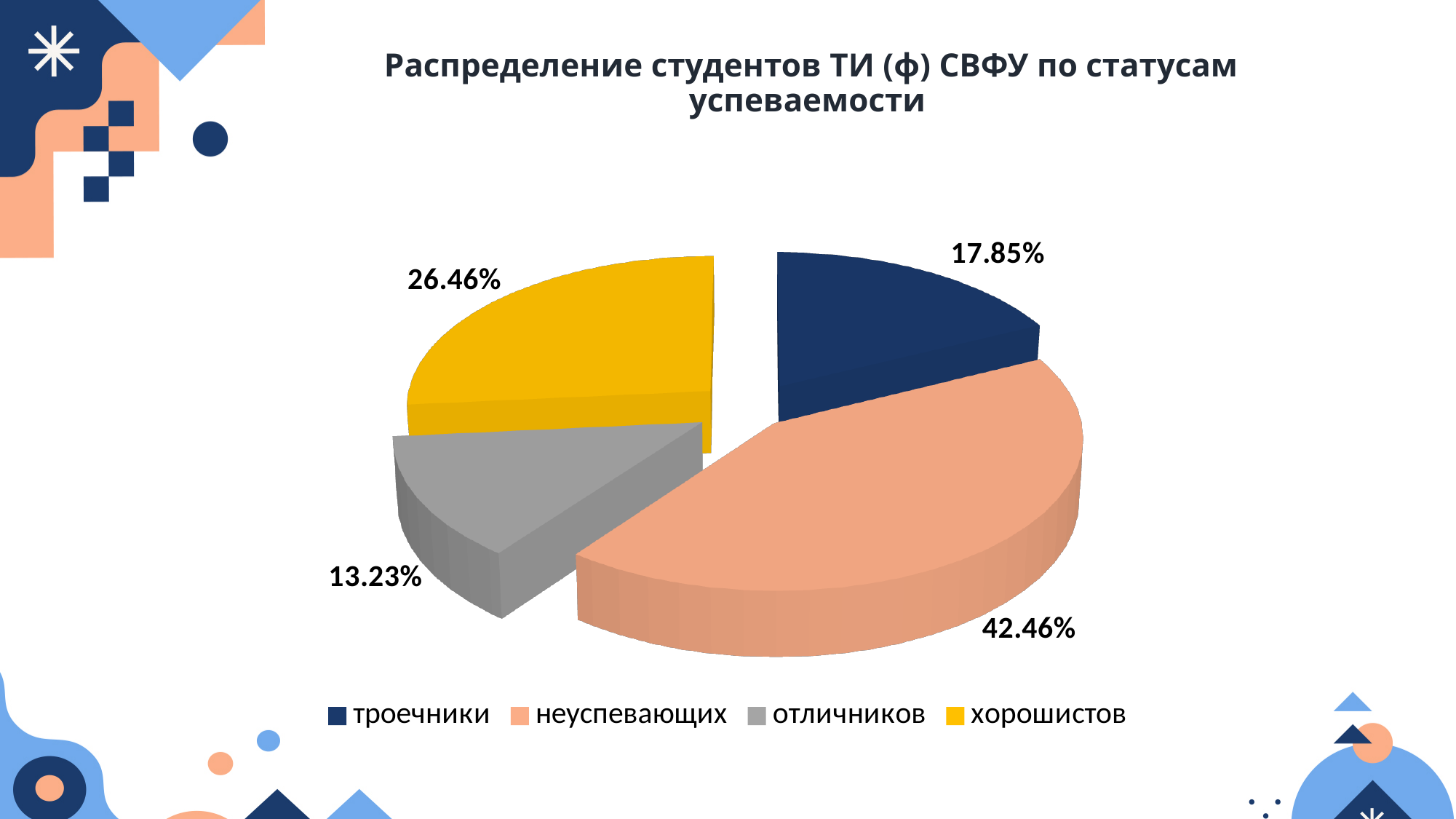
What percentage of students are отличников? 13.23% Which colour represents хорошистов in the chart? Yellow What percentage of students are неуспевающих? 42.46% Which category has the smallest share of students? отличников What is the difference in percentage points between хорошистов and отличников? 13.23 Which category has the largest share of students? неуспевающих What is the title of the chart? Распределение студентов ТИ (ф) СВФУ по статусам успеваемости How many categories does the pie chart show? 4 Which is larger: the share of троечники or the share of хорошистов? хорошистов What percentage of students are троечники? 17.85% What type of chart is shown on the slide? Pie chart What percentage of students are хорошистов? 26.46%